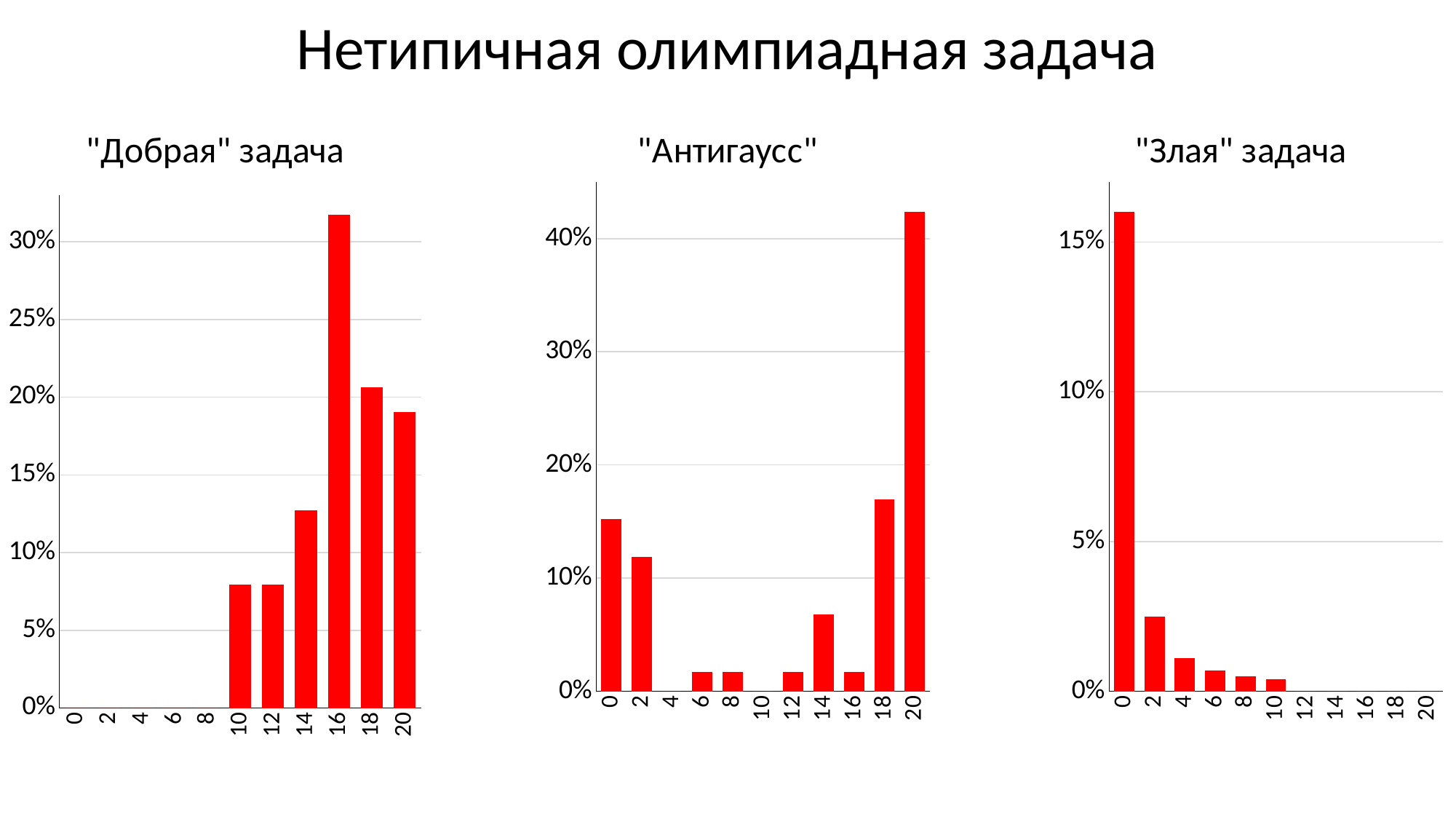
In the "Добрая" задача chart, is the value for 16 greater or less than 30%? greater How many x-axis categories are shown in the "Злая" задача chart? 11 In the "Злая" задача chart, do the values rise or fall from 0 to 10 along the x axis? fall In the "Добрая" задача chart, which is larger, the value for 14 or the value for 18? 18 What kind of chart is the "Добрая" задача chart? bar chart In the "Добрая" задача chart, is the value for 10 greater or less than 10%? less In the "Антигаусс" chart, is the value for 20 greater or less than 40%? greater In the "Антигаусс" chart, which x-axis value has the highest bar? 20 In the "Злая" задача chart, which x-axis value has the highest bar? 0 In the "Антигаусс" chart, which is larger, the value for 0 or the value for 2? 0 In the "Добрая" задача chart, which x-axis value has the highest bar? 16